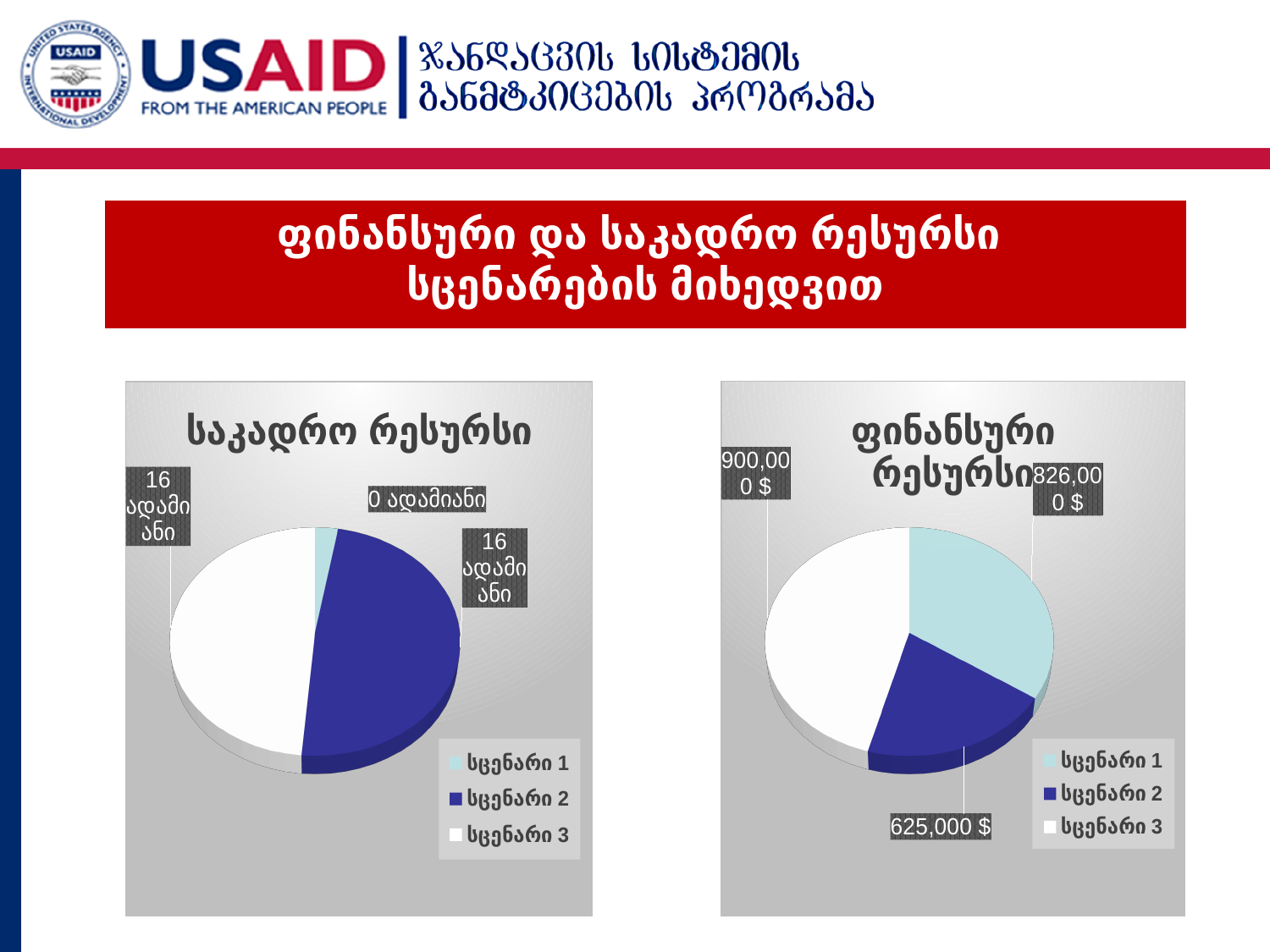
How many pie charts are shown on the slide? 2 In the "ფინანსური რესურსი" chart, what is the value for სცენარი 1? 826,000 $ In the "ფინანსური რესურსი" chart, which is larger: სცენარი 1 or სცენარი 2? სცენარი 1 In the "საკადრო რესურსი" chart, what is the value for სცენარი 3? 16 ადამიანი In the "ფინანსური რესურსი" chart, which scenario has the highest value? სცენარი 3 In the "ფინანსური რესურსი" chart, what is the value for სცენარი 2? 625,000 $ In the "ფინანსური რესურსი" chart, what is the value for სცენარი 3? 900,000 $ In the "საკადრო რესურსი" chart, what is the value for სცენარი 2? 16 ადამიანი How many series does the legend of the "ფინანსური რესურსი" chart list? 3 In the "ფინანსური რესურსი" chart, what is the difference between სცენარი 3 and სცენარი 2? 275,000 $ What type of chart is the "საკადრო რესურსი" chart on the left? pie chart In the "ფინანსური რესურსი" chart, which scenario has the lowest value? სცენარი 2